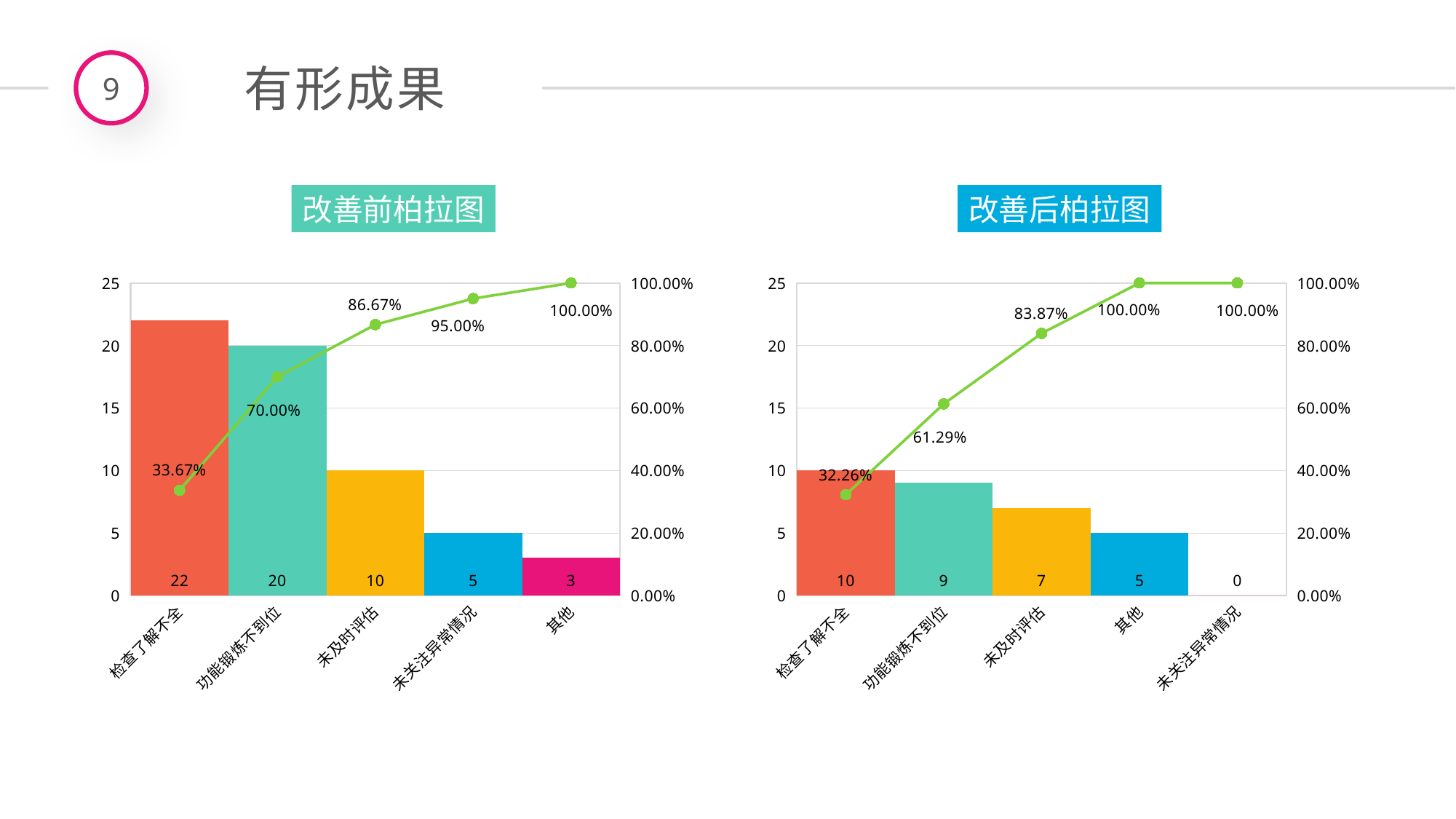
In the 改善后柏拉图 chart, what is the bar value for 未关注异常情况? 0 In the 改善后柏拉图 chart, what is the bar value for 未及时评估? 7 In the 改善前柏拉图 chart, what is the bar value for 检查了解不全? 22 In the 改善前柏拉图 chart, which category has the lowest bar? 其他 In the 改善前柏拉图 chart, how many categories are shown on the x axis? 5 Which is larger: the bar for 检查了解不全 in the 改善前柏拉图 chart or the bar for 检查了解不全 in the 改善后柏拉图 chart? 改善前柏拉图 What kind of chart is the 改善前柏拉图 chart? Bar chart with a line (Pareto chart) In the 改善后柏拉图 chart, do the bar values rise or fall from left to right along the x axis? fall In the 改善前柏拉图 chart, what is the difference between the bar values for 检查了解不全 and 未及时评估? 12 In the 改善前柏拉图 chart, what cumulative percentage is labelled at 功能锻炼不到位? 70.00% In the 改善后柏拉图 chart, what cumulative percentage is labelled at 功能锻炼不到位? 61.29% In the 改善后柏拉图 chart, which category has the highest bar? 检查了解不全